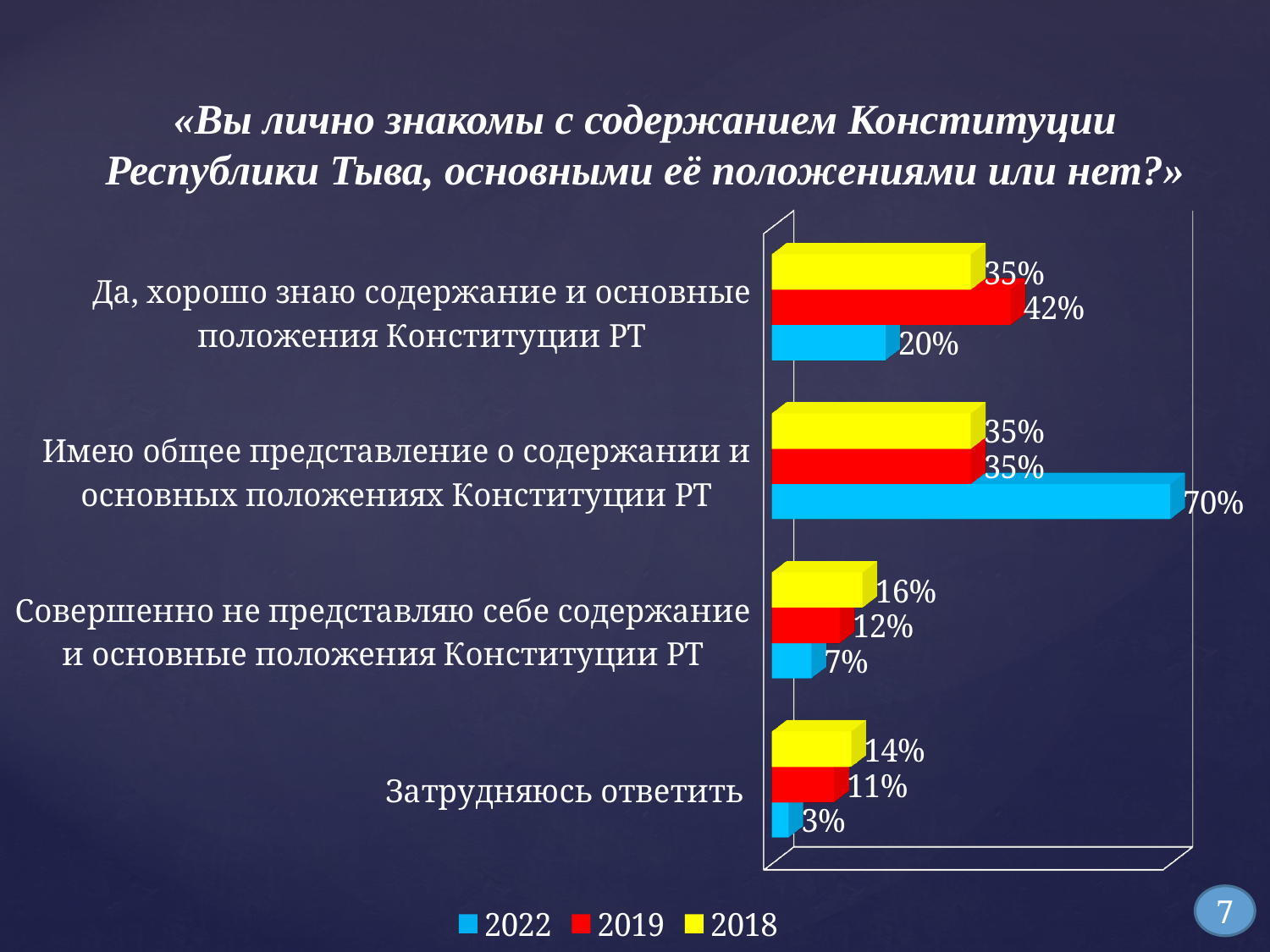
What is the 2022 value for «Совершенно не представляю себе содержание и основные положения Конституции РТ»? 7% For «Совершенно не представляю себе содержание и основные положения Конституции РТ», which is larger: the 2018 value or the 2019 value? 2018 Which category has the lowest 2019 value? Затрудняюсь ответить What type of chart is shown on the slide? bar chart How many series does the legend list? 3 How many response categories are shown in the chart? 4 Which category has the highest 2022 value? Имею общее представление о содержании и основных положениях Конституции РТ Which colour represents the 2019 series in the legend? red What is the 2018 value for «Затрудняюсь ответить»? 14% What is the 2019 value for «Да, хорошо знаю содержание и основные положения Конституции РТ»? 42% What is the difference between the 2019 and 2022 values for «Да, хорошо знаю содержание и основные положения Конституции РТ»? 22% What is the 2022 value for «Имею общее представление о содержании и основных положениях Конституции РТ»? 70%